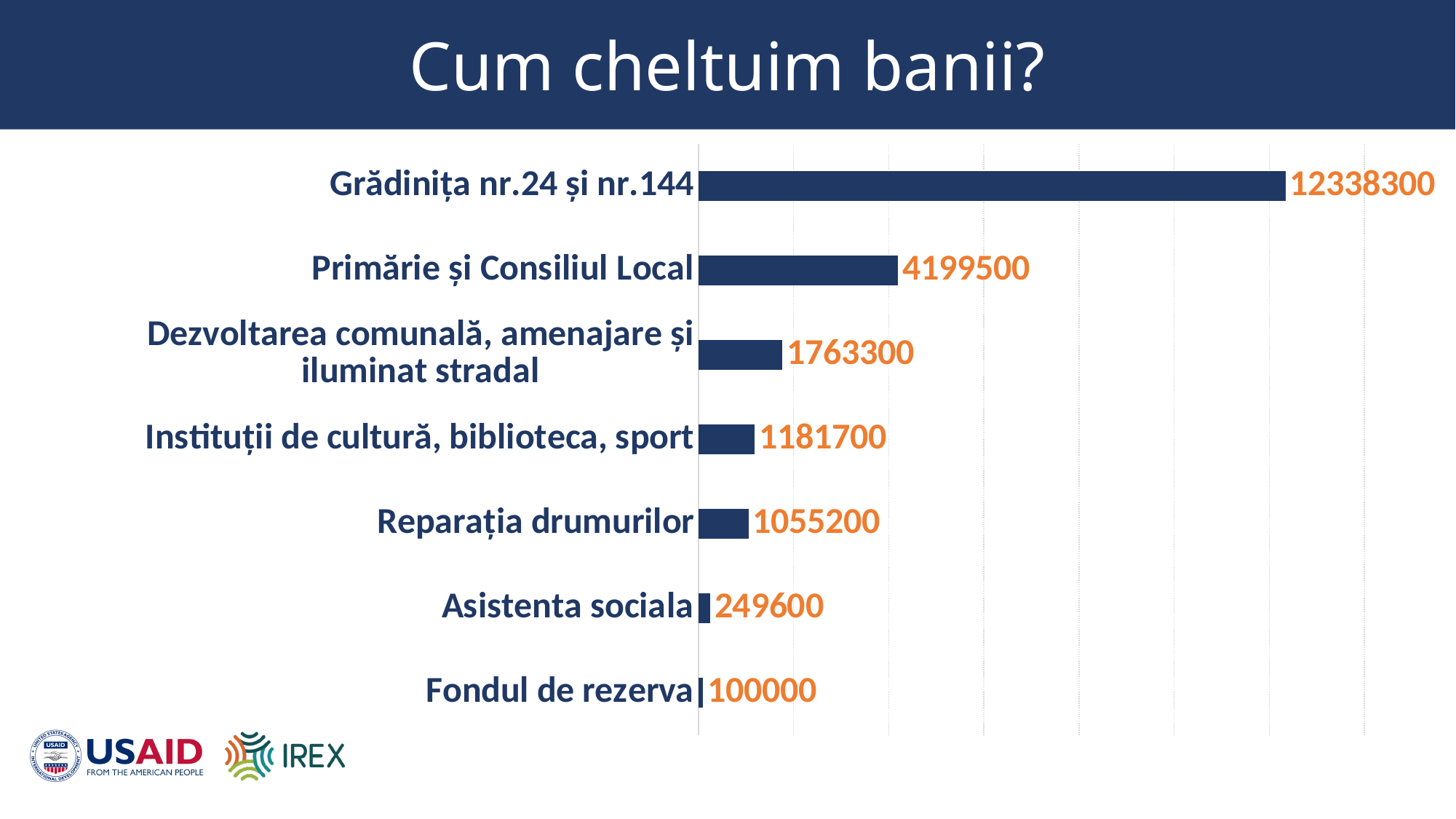
Which category has the lowest value? Fondul de rezerva What is the value for Asistenta sociala? 249600 How many categories are shown in the chart? 7 What is the difference between the values for Instituții de cultură, biblioteca, sport and Reparația drumurilor? 126500 What is the value for Reparația drumurilor? 1055200 What is the title of the slide? Cum cheltuim banii? What is the value for Grădinița nr.24 și nr.144? 12338300 What is the difference between the values for Grădinița nr.24 și nr.144 and Primărie și Consiliul Local? 8138800 What kind of chart is shown on the slide? Bar chart What is the value for Primărie și Consiliul Local? 4199500 Which category has the highest value? Grădinița nr.24 și nr.144 Which is larger: the value for Dezvoltarea comunală, amenajare și iluminat stradal or the value for Instituții de cultură, biblioteca, sport? Dezvoltarea comunală, amenajare și iluminat stradal